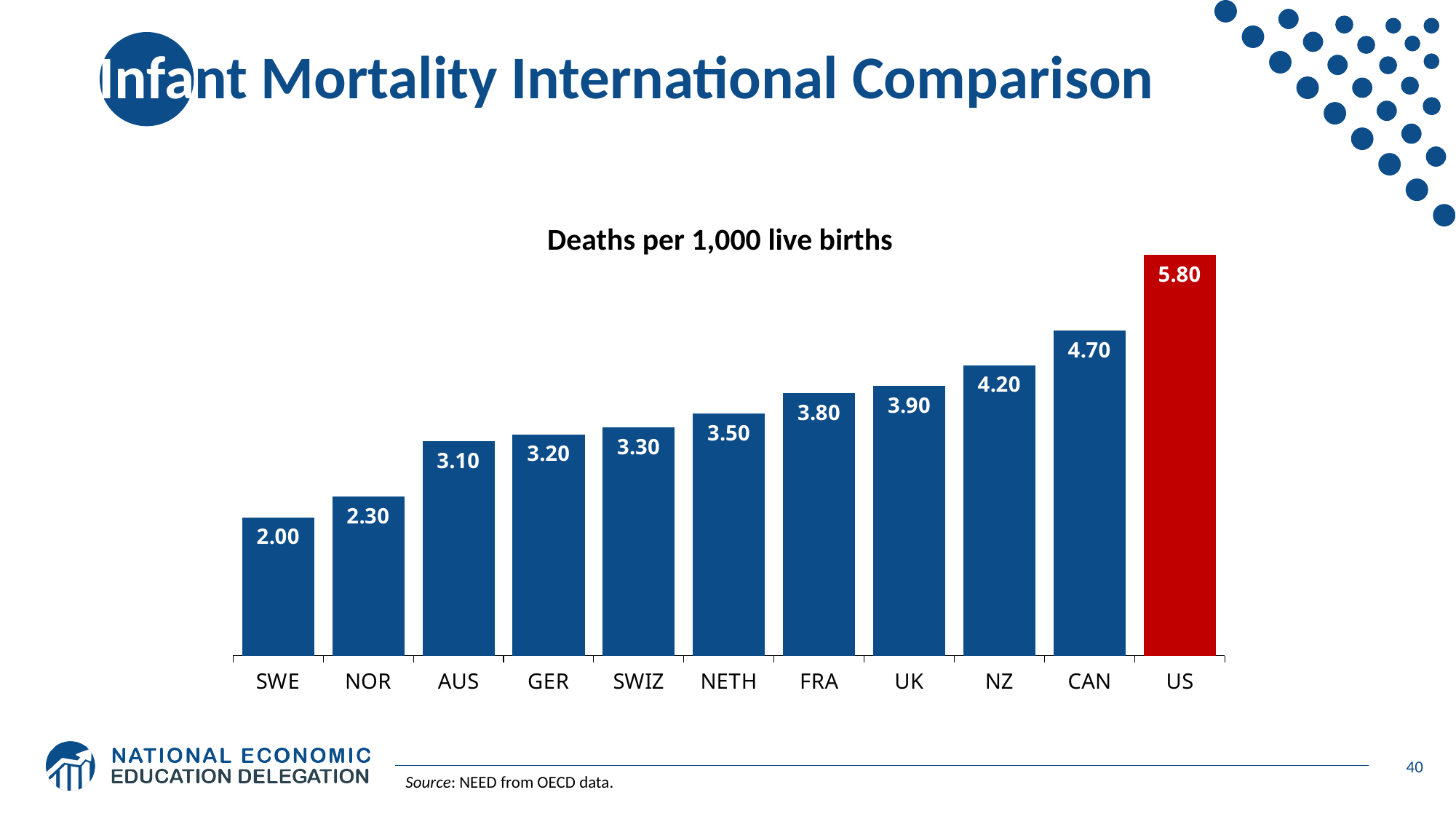
What is the value for the US in the chart? 5.80 How many countries are shown in the chart? 11 What is the difference between the values for NOR and SWE? 0.30 Do the values rise or fall from left to right along the x axis? Rise What is the difference between the values for the US and CAN? 1.10 Which has a larger value, FRA or NZ? NZ Which country has the highest value in the chart? US What kind of chart is shown on the slide? Bar chart What is the value for NETH in the chart? 3.50 What is the value for SWE in the chart? 2.00 Which country has the lowest value in the chart? SWE Which bar in the chart is coloured red? US